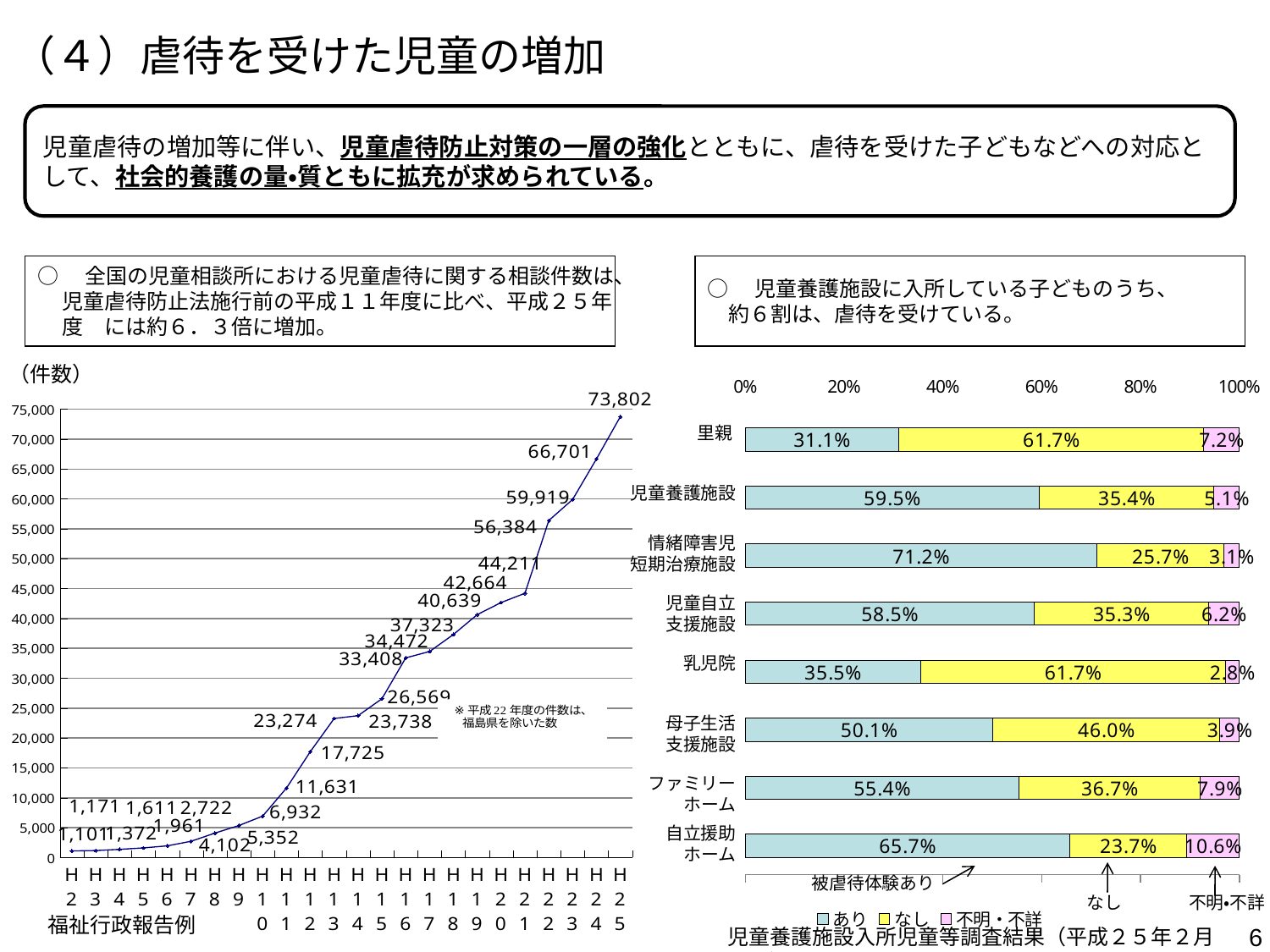
On the left line chart, what is the difference between the values for H25 and H24? 7,101 On the right bar chart, which facility type has the highest あり percentage? 情緒障害児短期治療施設 On the right bar chart, what is the 不明・不詳 percentage for 自立援助ホーム? 10.6% On the right bar chart, what is the あり (abuse experienced) percentage for 児童養護施設? 59.5% On the left line chart, what is the value for 平成11 (H11)? 11,631 What kind of chart is the chart on the left of the slide? line chart On the right bar chart, which facility type has the lowest あり percentage? 里親 On the left line chart, do the values generally rise or fall from H2 to H25? rise How many series does the legend of the right bar chart list? 3 On the left line chart, what is the value for 平成25 (H25)? 73,802 On the right bar chart, which is larger: the あり percentage for 乳児院 or for 母子生活支援施設? 母子生活支援施設 How many facility types are shown on the right bar chart? 8